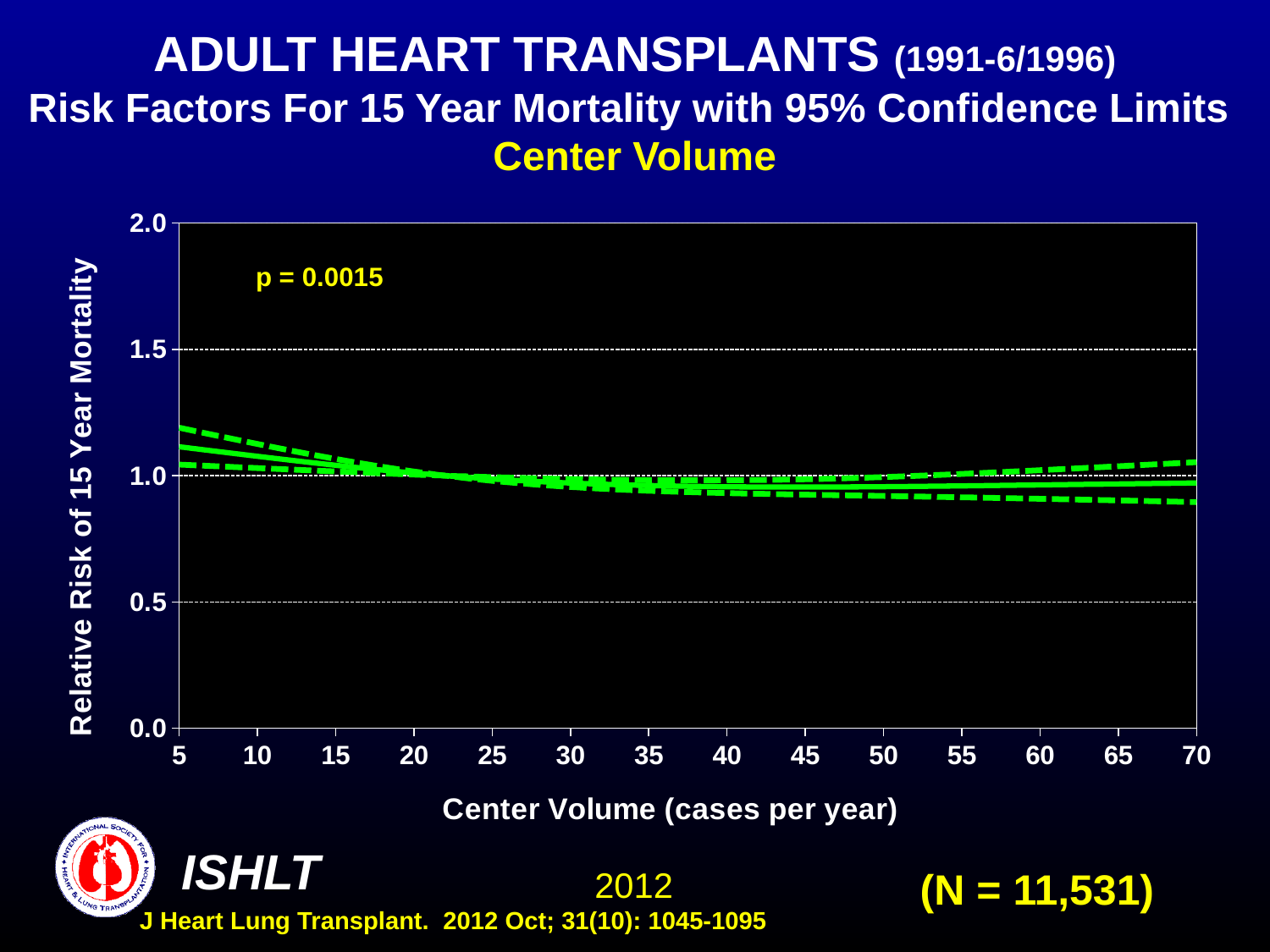
Is the relative risk of 15 year mortality at a center volume of 60 cases per year greater or less than 0.5? greater What kind of chart is shown on the slide? line chart Is the relative risk of 15 year mortality at a center volume of 5 cases per year greater or less than 1.5? less Is the relative risk of 15 year mortality at a center volume of 40 cases per year greater or less than 1.5? less How many tick labels are shown on the x axis of the chart? 14 What p-value is printed on the chart? p = 0.0015 Is the relative risk of 15 year mortality higher at a center volume of 5 or at a center volume of 50 cases per year? 5 What is the highest value labelled on the y axis of the chart? 2.0 Does the relative risk of 15 year mortality rise or fall as center volume increases from 5 to 70 cases per year? fall